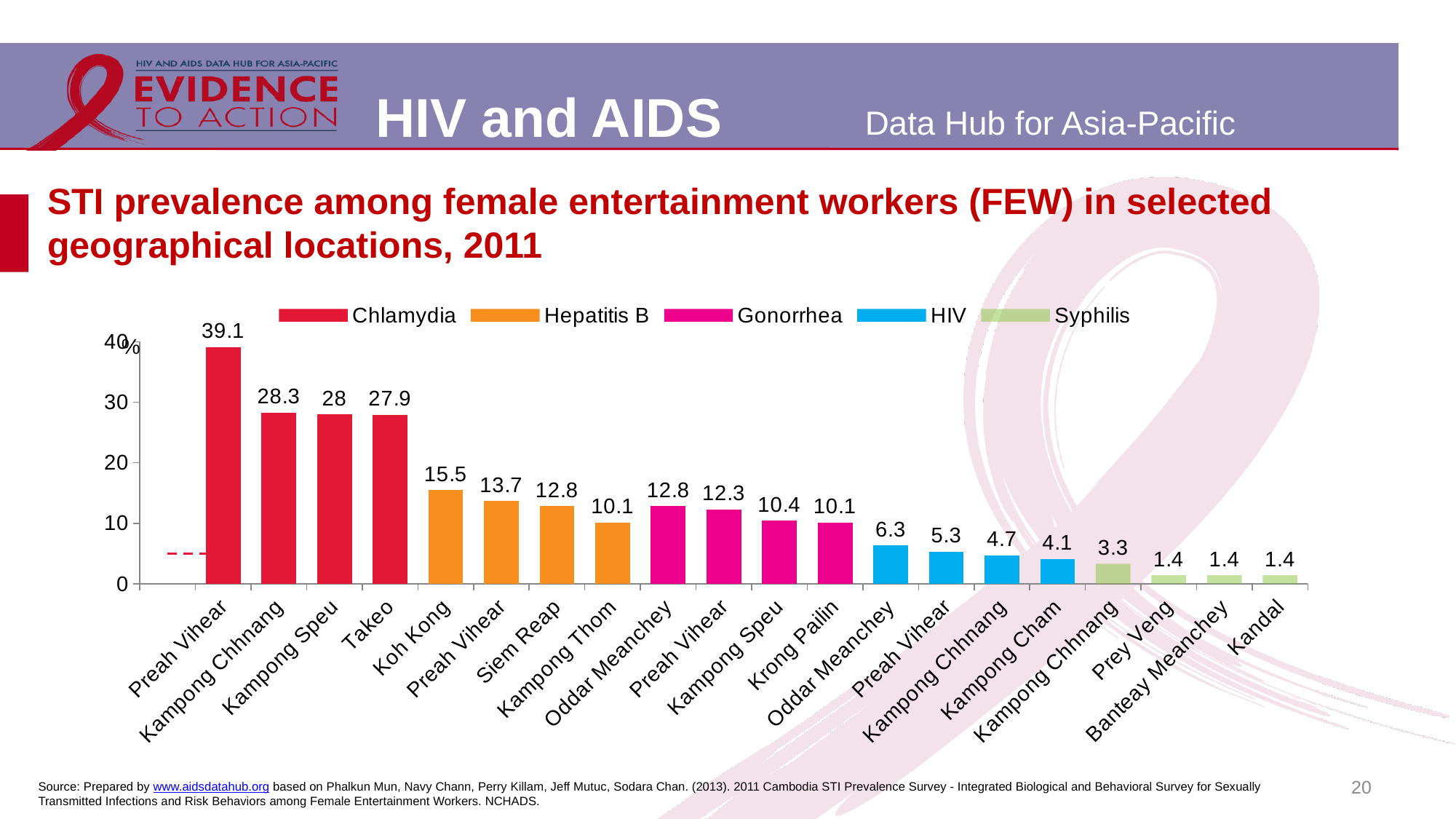
What type of chart is shown on the slide? Bar chart Which is larger: the Gonorrhea prevalence in Oddar Meanchey or the Hepatitis B prevalence in Siem Reap? They are equal (12.8) What is the difference between the Chlamydia prevalence in Preah Vihear and in Kampong Chhnang? 10.8 How many series does the legend list? 5 How many bars are plotted on the chart? 20 What is the HIV prevalence among FEW in Kampong Cham? 4.1 What is the Syphilis prevalence among FEW in Kampong Chhnang? 3.3 Which is larger: the Hepatitis B prevalence in Preah Vihear or the Gonorrhea prevalence in Preah Vihear? Hepatitis B (13.7) What is the Hepatitis B prevalence among FEW in Koh Kong? 15.5 Which location has the lowest HIV prevalence on the chart? Kampong Cham What is the Chlamydia prevalence among FEW in Preah Vihear? 39.1 Which location has the highest Chlamydia prevalence on the chart? Preah Vihear